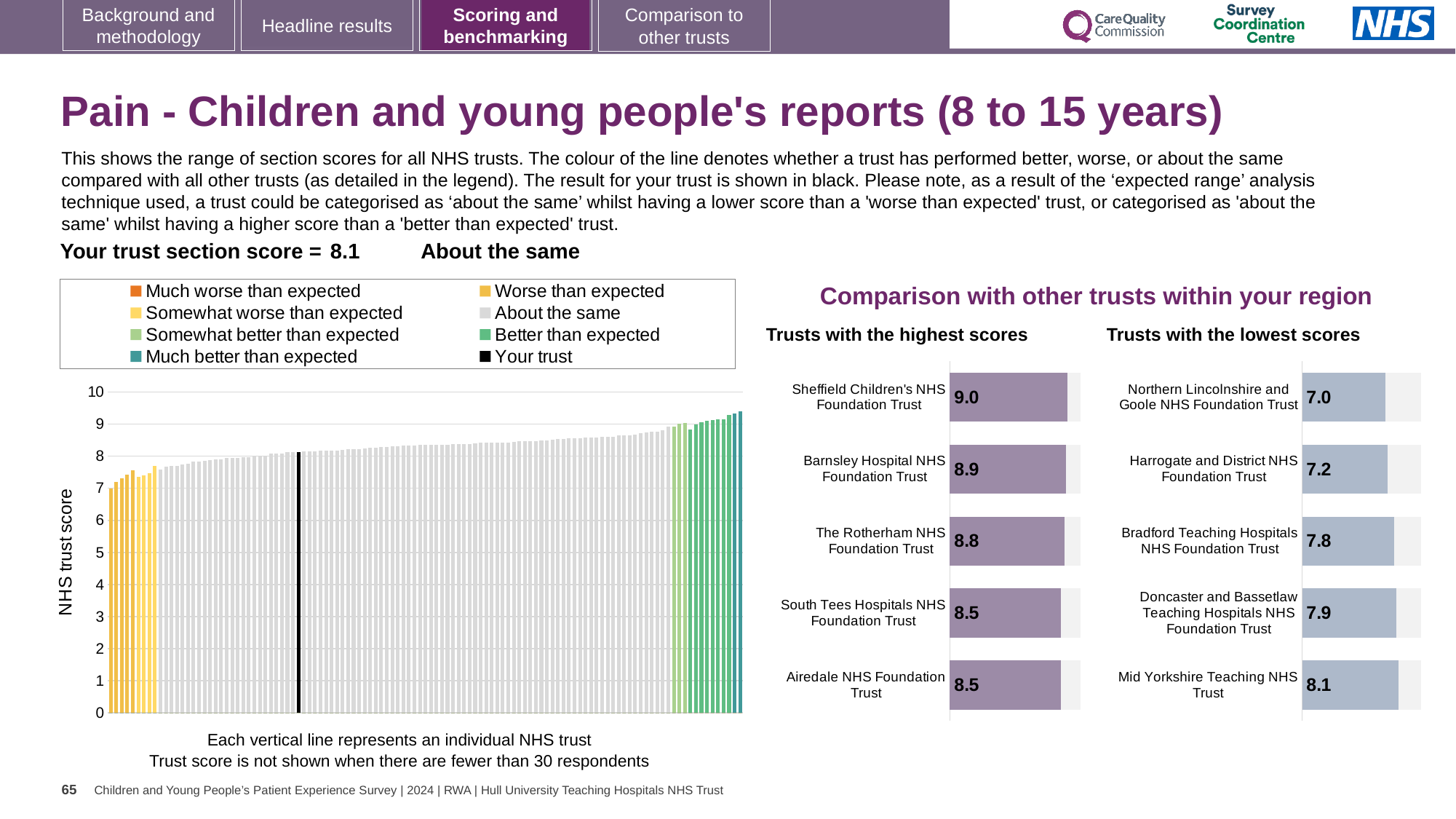
How many entries does the legend of the left-hand chart list? 8 How many trusts are listed in the 'Trusts with the lowest scores' chart? 5 In the 'Trusts with the highest scores' chart, what is the difference between the scores of Sheffield Children's NHS Foundation Trust and South Tees Hospitals NHS Foundation Trust? 0.5 In the left-hand chart of all NHS trusts, do the bar heights rise or fall from left to right? rise In the 'Trusts with the lowest scores' chart, which trust has the lowest score? Northern Lincolnshire and Goole NHS Foundation Trust In the 'Trusts with the highest scores' chart, what is the score for The Rotherham NHS Foundation Trust? 8.8 In the 'Trusts with the lowest scores' chart, what is the score for Harrogate and District NHS Foundation Trust? 7.2 In the 'Trusts with the highest scores' chart, which trust has the highest score? Sheffield Children's NHS Foundation Trust In the left-hand chart of all NHS trusts, what is the section score for your trust (the black bar)? 8.1 In the 'Trusts with the highest scores' chart, what is the score for Sheffield Children's NHS Foundation Trust? 9.0 In the 'Trusts with the lowest scores' chart, which has the higher score: Harrogate and District NHS Foundation Trust or Bradford Teaching Hospitals NHS Foundation Trust? Bradford Teaching Hospitals NHS Foundation Trust In the 'Trusts with the lowest scores' chart, what is the difference between the scores of Mid Yorkshire Teaching NHS Trust and Northern Lincolnshire and Goole NHS Foundation Trust? 1.1